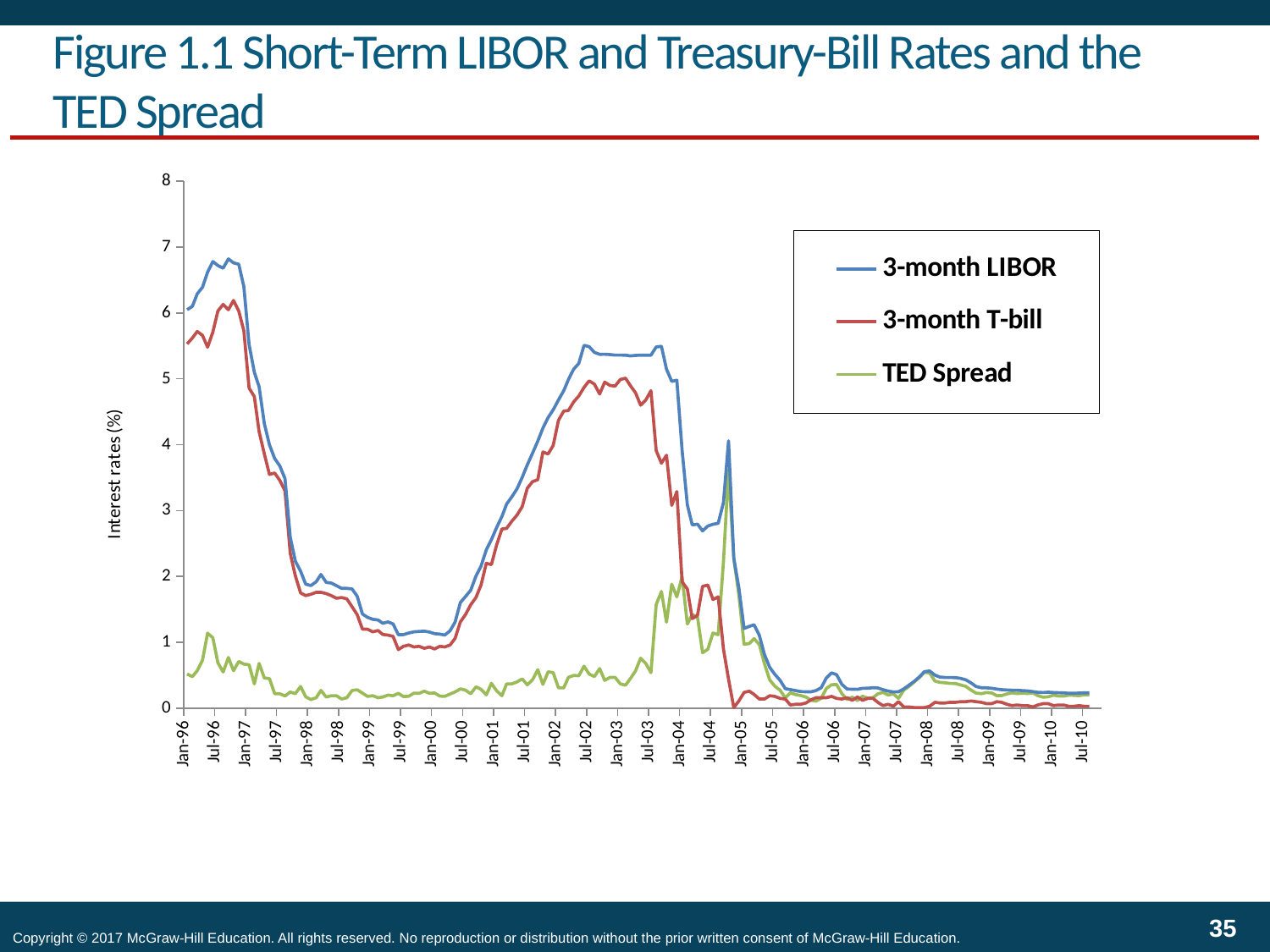
What is the label on the vertical axis? Interest rates (%) What kind of chart is shown on the slide? line chart How many series does the legend list? 3 Is the value for 3-month LIBOR at Jul-10 greater or less than 1? less Which series reaches the highest value anywhere on the chart? 3-month LIBOR What are the three series named in the legend? 3-month LIBOR, 3-month T-bill, TED Spread Is the value for 3-month LIBOR at Jul-02 greater or less than 5? greater Does the 3-month LIBOR rise or fall between Jan-00 and Jul-02? rise Is the value for 3-month T-bill at Jul-99 greater or less than 1? less At Jan-97, which is larger: 3-month LIBOR or 3-month T-bill? 3-month LIBOR